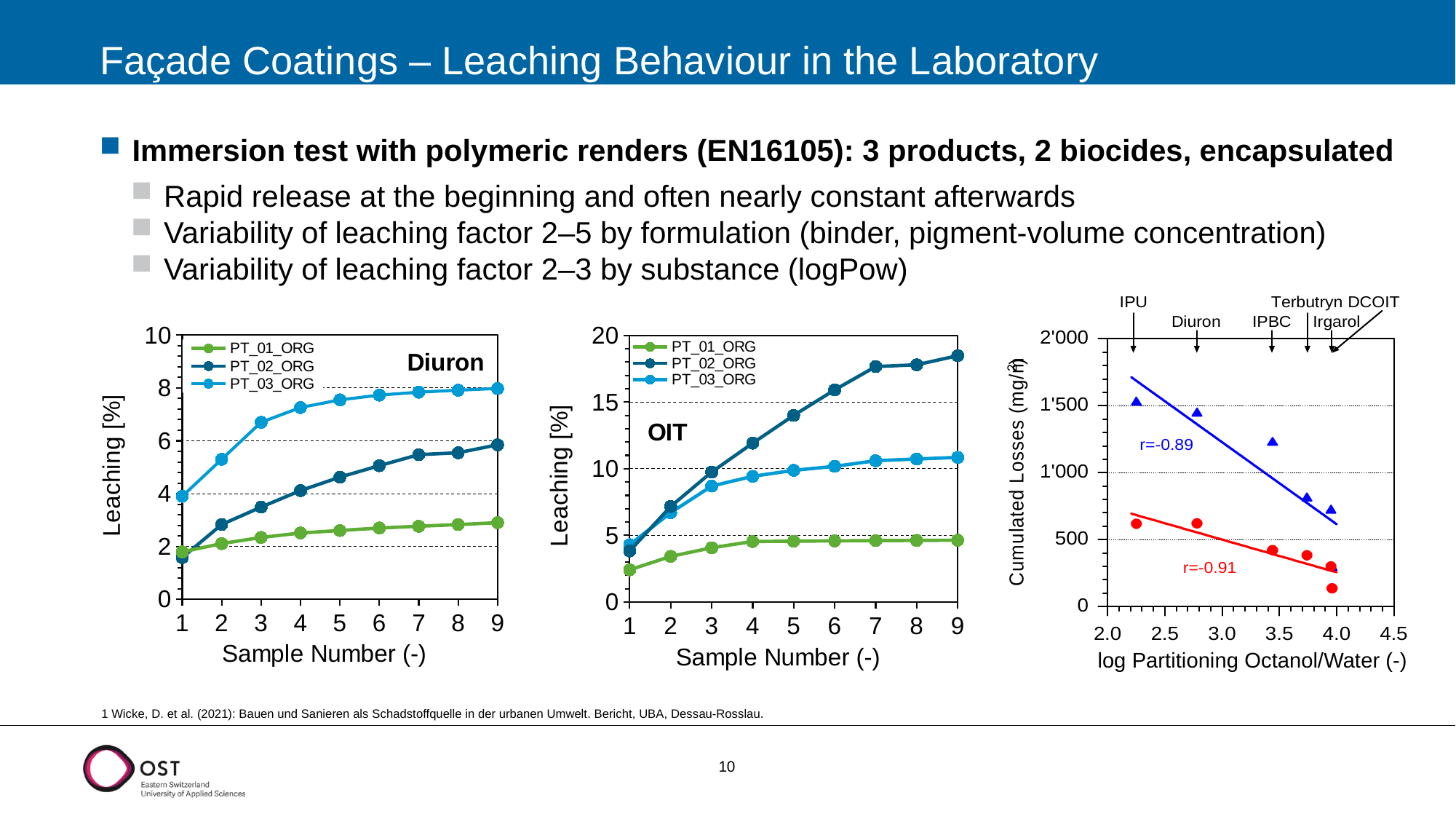
In the OIT chart, which series has the highest leaching value at sample number 9? PT_02_ORG In the Diuron chart, how many series does the legend list? 3 In the OIT chart, does the leaching value for PT_02_ORG rise or fall as the sample number increases? rise In the OIT chart, how many sample numbers are plotted along the x axis? 9 In the Diuron chart, which series has the highest leaching value at sample number 9? PT_03_ORG In the OIT chart, is the leaching value for PT_02_ORG at sample number 9 greater or less than 15? greater In the Diuron chart, is the leaching value for PT_01_ORG at sample number 9 greater or less than 4? less In the Diuron chart, which series has the lowest leaching value at sample number 9? PT_01_ORG In the rightmost chart, what correlation coefficient is shown for the blue series? r=-0.89 In the Diuron chart, is the leaching value for PT_03_ORG at sample number 9 greater or less than 6? greater What kind of chart is the rightmost chart (Cumulated Losses vs log Partitioning Octanol/Water)? scatter chart In the OIT chart, at sample number 9, which is larger: the value for PT_02_ORG or PT_03_ORG? PT_02_ORG